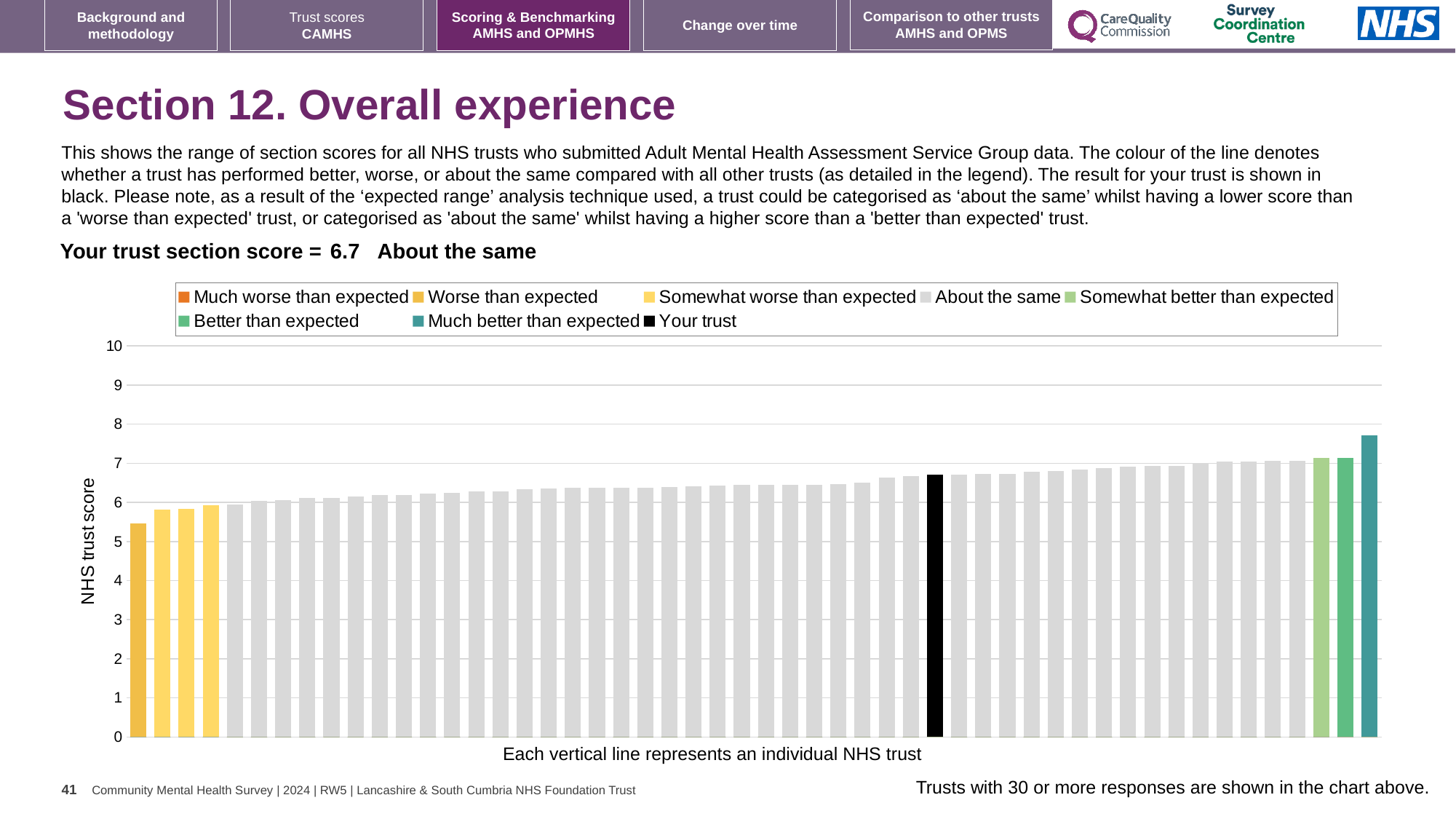
What is the title of the vertical axis of the chart? NHS trust score What is the section score for your trust shown on the slide? 6.7 Which legend category does the tallest bar in the chart belong to? Much better than expected Which is larger: the value of the black 'Your trust' bar or the value of the leftmost bar? Your trust What kind of chart is shown on the slide? bar chart Is the value of the black 'Your trust' bar greater or less than 6? greater Is the value of the tallest bar in the chart greater or less than 7? greater How many entries does the chart legend list? 8 Is the value of the leftmost bar in the chart greater or less than 6? less Which category is your trust's section score placed in? About the same Do the bar values rise or fall from left to right along the x axis? rise What colour is the bar representing your trust in the chart? black